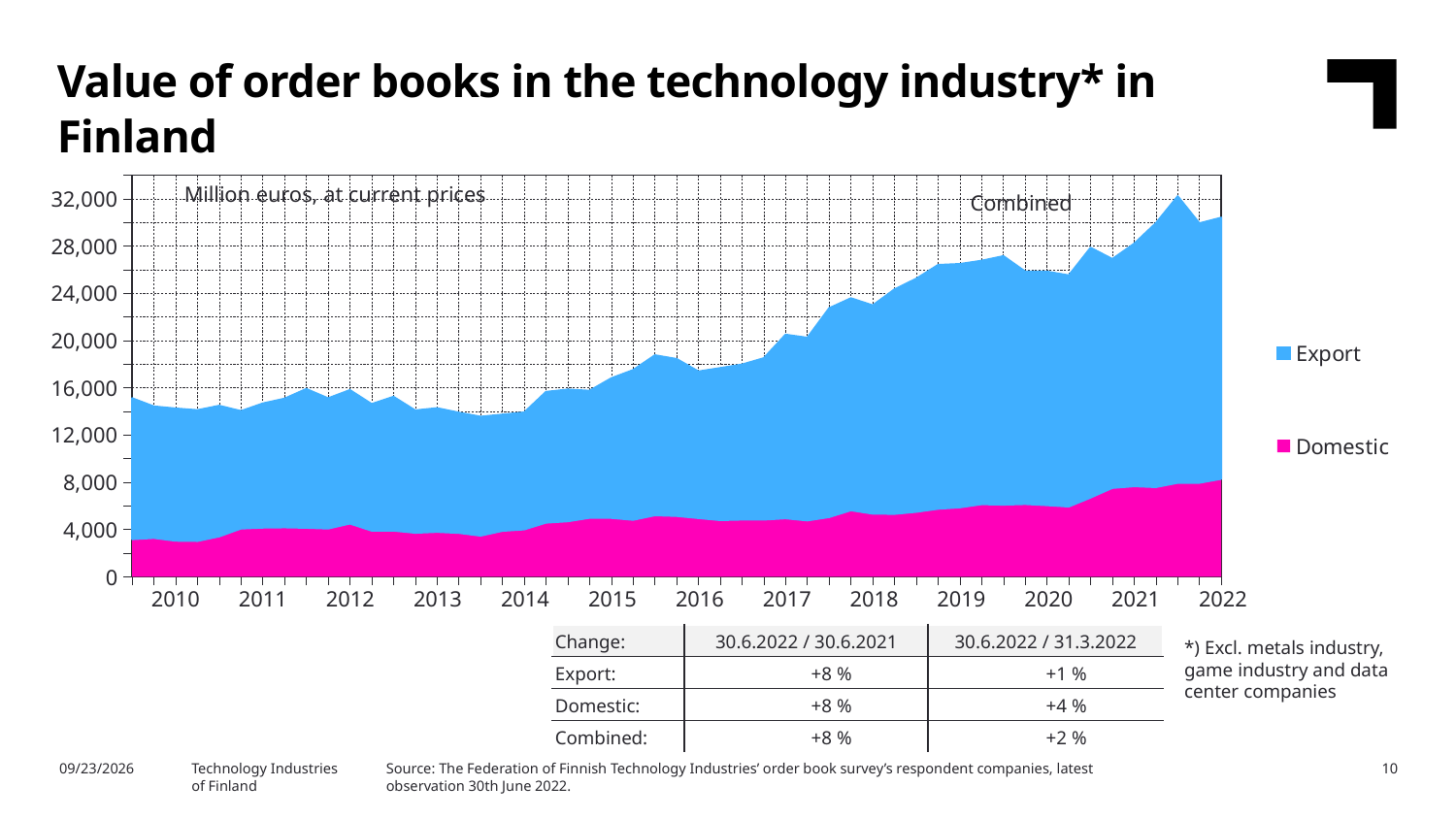
Is the Domestic value at the start of 2010 greater or less than 4,000? less How many years are labelled on the x axis? 13 What are the two series named in the legend? Export and Domestic Is the combined value in 2022 greater or less than 28,000? greater Which series is larger throughout the chart, Export or Domestic? Export What kind of chart is shown on the slide? Stacked area chart Does the combined value of order books generally rise or fall from 2010 to 2022? rise Is the combined value at the start of 2010 greater or less than 12,000? greater What is the highest value shown on the y axis? 32,000 How many series does the legend list? 2 What unit is stated for the values in the chart? Million euros, at current prices